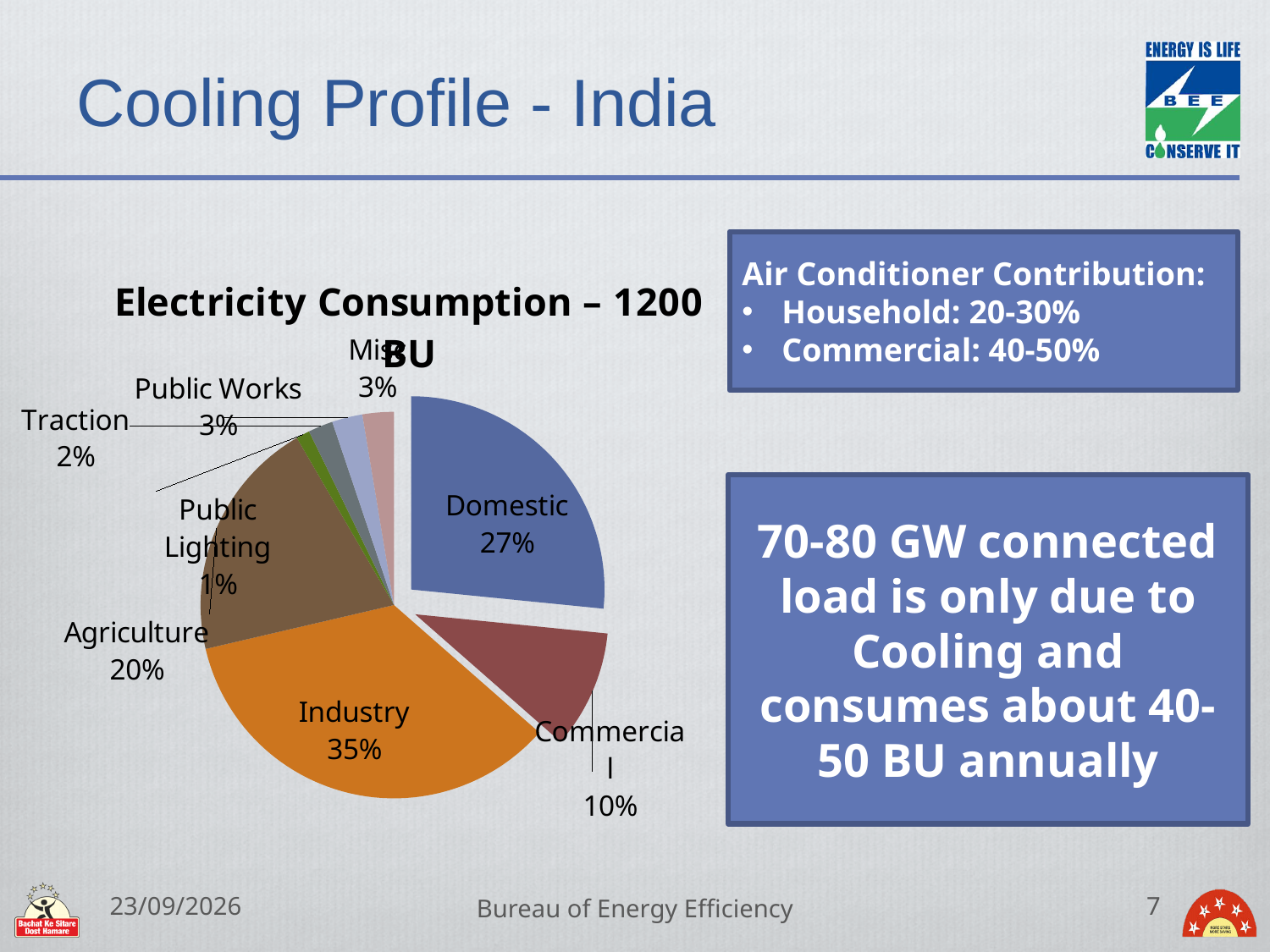
Which category has the largest share of electricity consumption? Industry What is the title of the chart? Electricity Consumption – 1200 BU By how many percentage points does Industry exceed Domestic? 8 percentage points What type of chart is shown on the slide? Pie chart What is the value shown for Traction? 2% What percentage is shown for Commercial? 10% What is the value shown for Agriculture? 20% What percentage of electricity consumption is attributed to Domestic? 27% Which category has the smallest share of electricity consumption? Public Lighting Which is larger, the share for Domestic or the share for Agriculture? Domestic What percentage is shown for Public Works? 3% What share of the pie does Industry account for? 35%